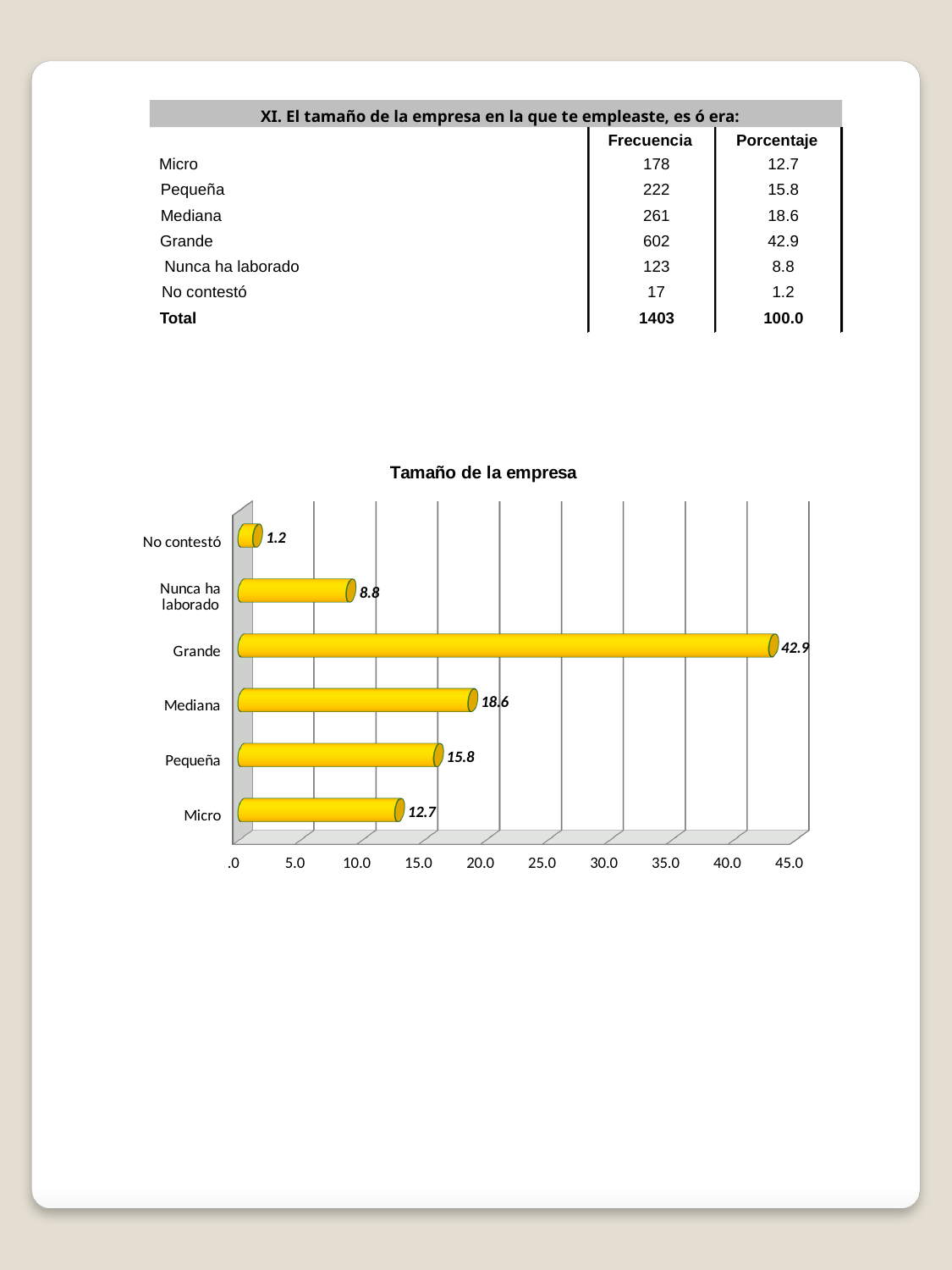
Which is larger, the value for Mediana or the value for Pequeña? Mediana What is the title of the chart? Tamaño de la empresa Which category has the highest value in the chart? Grande Is the value for Micro greater or less than 10.0? greater What is the value for Grande in the chart? 42.9 What is the difference between the values for Grande and Mediana? 24.3 How many categories are shown in the chart? 6 What is the difference between the values for Pequeña and Micro? 3.1 What is the value for Nunca ha laborado in the chart? 8.8 What kind of chart is shown on the slide? bar chart What is the value for Mediana in the chart? 18.6 Which category has the lowest value in the chart? No contestó